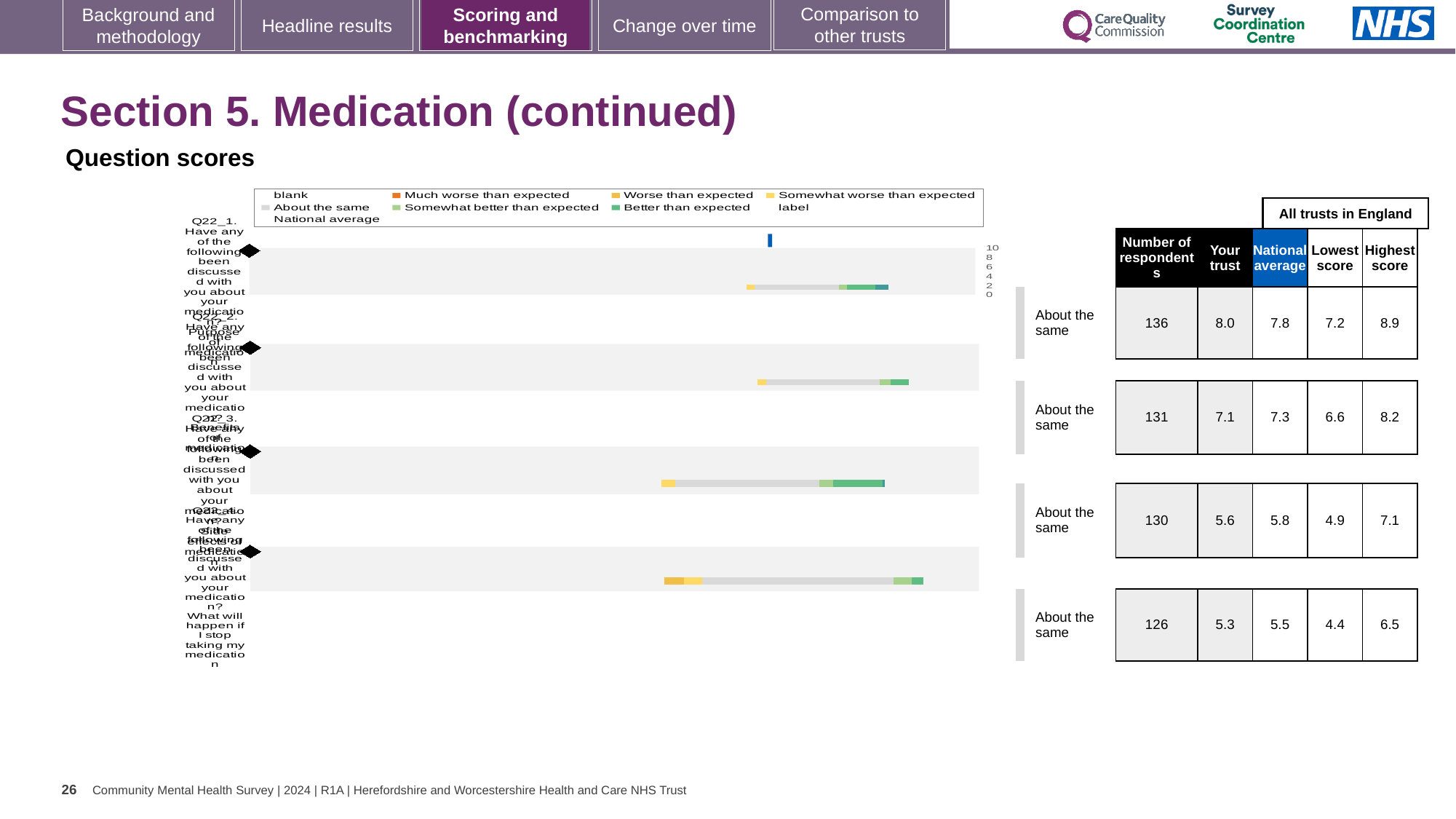
In the table, what is the number of respondents for the second row? 131 For the third row, what is the difference between the national average and the 'Your trust' score? 0.2 In the table, what is the national average for the third row? 5.8 For the first row (Q22_1), which is larger: the 'Your trust' score or the national average? Your trust In the table, what is the lowest score for the third row? 4.9 In the table, what is the 'Your trust' score for the first row (Q22_1)? 8.0 How many question rows (bars) are plotted in the chart? 4 What benchmark category is shown for every question row on the slide? About the same Which row has the highest 'Your trust' score? the first row (Q22_1), 8.0 What kind of chart is shown on the slide? bar chart In the table, what is the highest score for the fourth (bottom) row? 6.5 Which row has the lowest 'Your trust' score? the fourth (bottom) row, 5.3